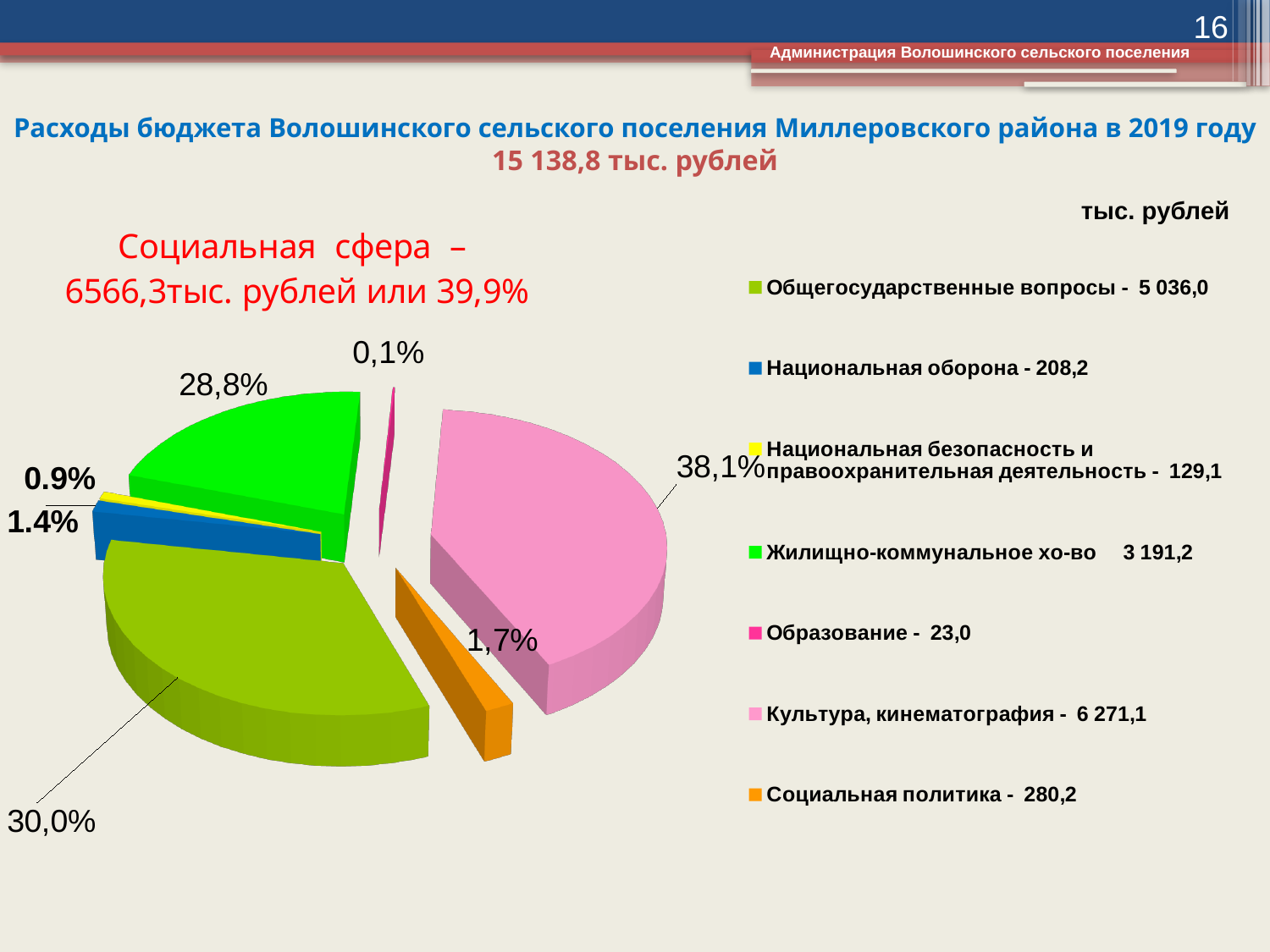
What kind of chart is shown on the slide? pie chart What is the difference between the values for Культура, кинематография and Общегосударственные вопросы? 1 235,1 What is the value for Культура, кинематография? 6 271,1 What is the value for Общегосударственные вопросы? 5 036,0 What is the value for Национальная оборона? 208,2 Which is larger, the value for Социальная политика or the value for Национальная оборона? Социальная политика Which category has the largest share of the pie? Культура, кинематография Which category has the smallest share of the pie? Образование What share of the pie does Культура, кинематография take? 38,1% What is the value for Жилищно-коммунальное хо-во? 3 191,2 How many categories does the pie chart's legend list? 7 What share of the pie does Жилищно-коммунальное хо-во take? 28,8%